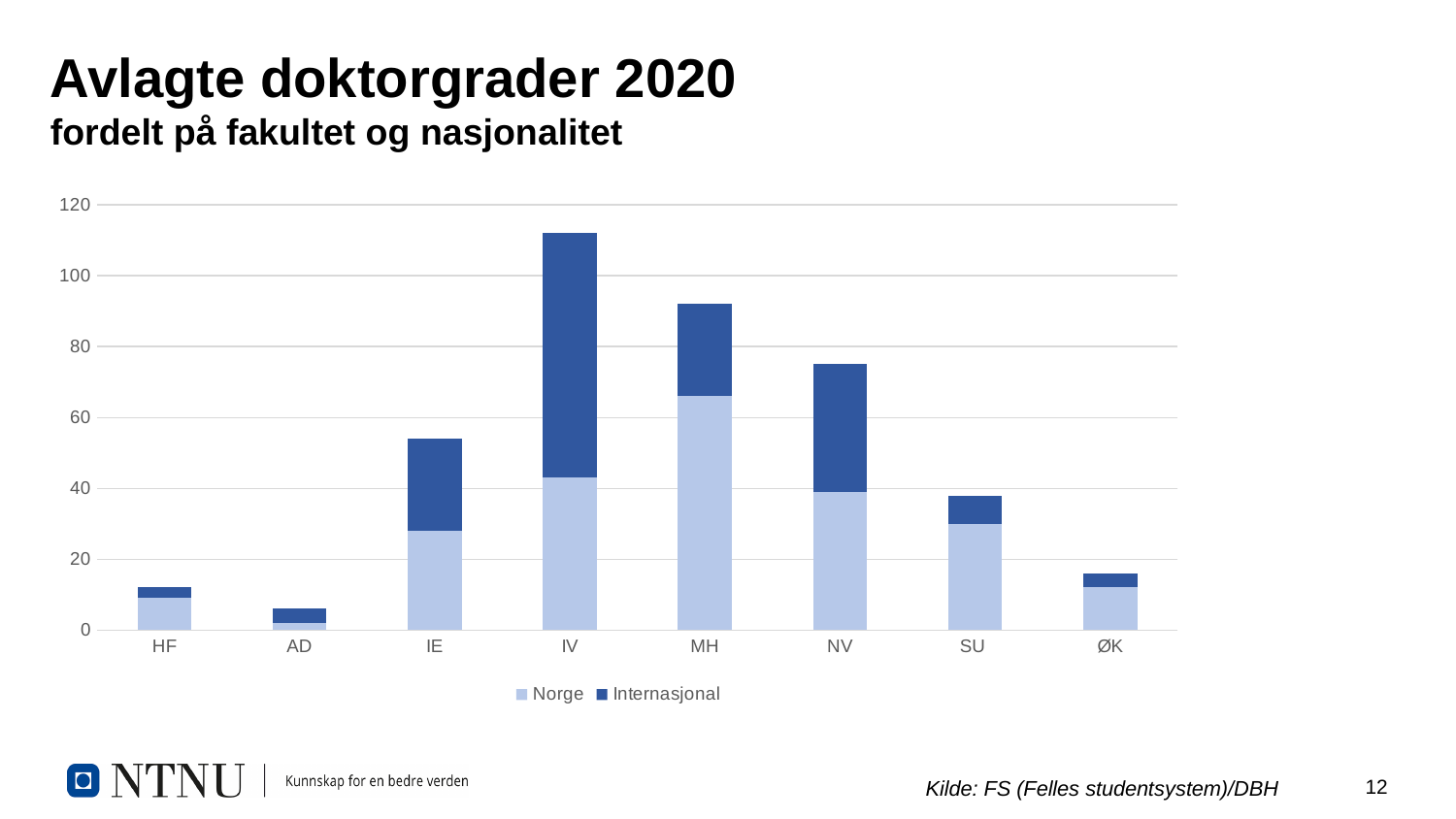
Is the total value for SU greater or less than 40? less Is the total value for IE greater or less than 60? less Which faculty has the highest total number of doctoral degrees? IV Is the total value for IV greater or less than 100? greater Which faculty has the lowest total number of doctoral degrees? AD Which faculty has the larger total, MH or NV? MH How many faculties are shown on the x axis? 8 What are the two series named in the legend? Norge and Internasjonal What kind of chart is shown on the slide? Stacked bar chart Which faculty has the larger Norge value, MH or IV? MH How many series does the legend list? 2